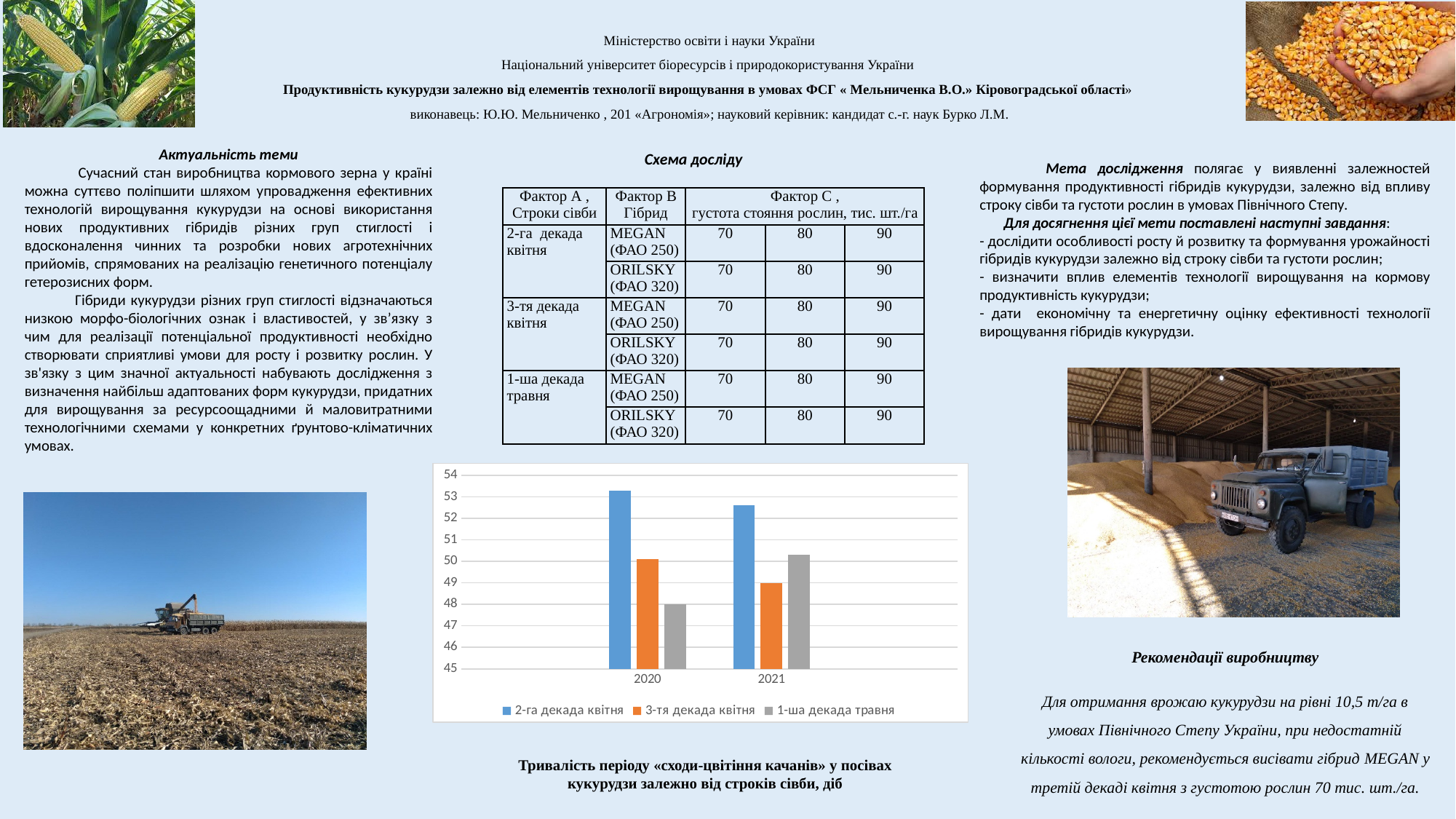
Which series has the lowest value in 2020? 1-ша декада травня What kind of chart is shown on the slide? bar chart Which series has the highest value in 2021? 2-га декада квітня Is the value for 3-тя декада квітня in 2021 greater or less than 50? less Which series in the bar chart is shown in grey? 1-ша декада травня Is the value for 1-ша декада травня in 2021 greater or less than 50? greater Is the value for 2-га декада квітня in 2020 greater or less than 53? greater How many categories are shown on the x axis of the bar chart? 2 How many series does the legend of the bar chart list? 3 Which is larger for 3-тя декада квітня: the value in 2020 or in 2021? 2020 Which series in the bar chart is shown in orange? 3-тя декада квітня